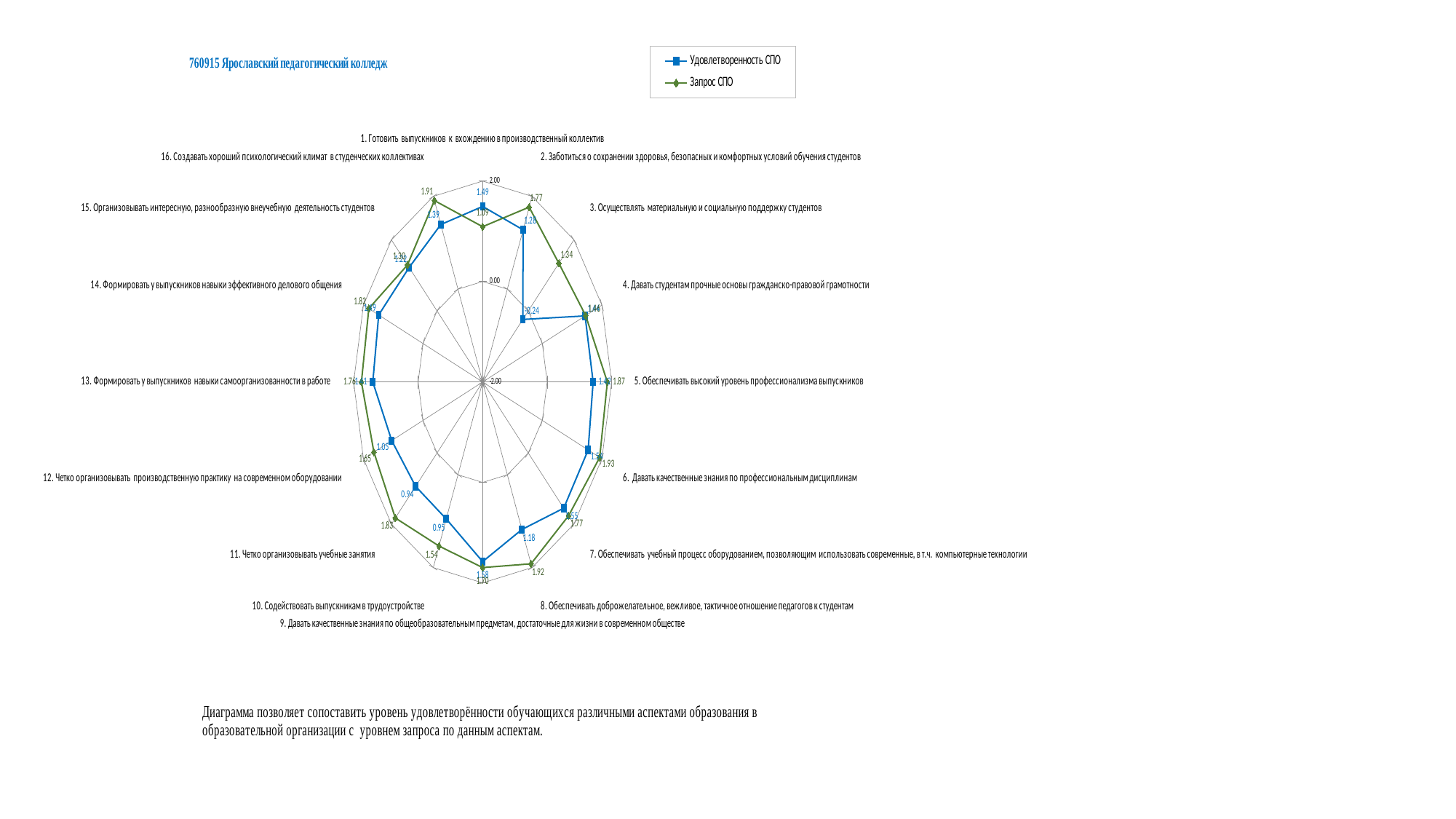
Which category has the lowest "Удовлетворенность СПО" value? 3. Осуществлять материальную и социальную поддержку студентов What kind of chart is shown on the slide? Radar chart Which category has the lowest "Запрос СПО" value? 1. Готовить выпускников к вхождению в производственный коллектив What is the value of "Запрос СПО" for category 5 (Обеспечивать высокий уровень профессионализма выпускников)? 1.87 What is the value of "Удовлетворенность СПО" for category 9 (Давать качественные знания по общеобразовательным предметам)? 1.58 What is the value of "Удовлетворенность СПО" for category 6 (Давать качественные знания по профессиональным дисциплинам)? 1.54 What is the value of "Запрос СПО" for category 8 (Обеспечивать доброжелательное, вежливое, тактичное отношение педагогов к студентам)? 1.92 For category 8, what is the difference between "Запрос СПО" (1.92) and "Удовлетворенность СПО" (1.18)? 0.74 How many series does the legend list? 2 How many categories (aspects) are plotted on the radar chart? 16 For category 1 (Готовить выпускников к вхождению в производственный коллектив), which series has the higher value? Удовлетворенность СПО What is the value of "Запрос СПО" for category 11 (Четко организовывать учебные занятия)? 1.83